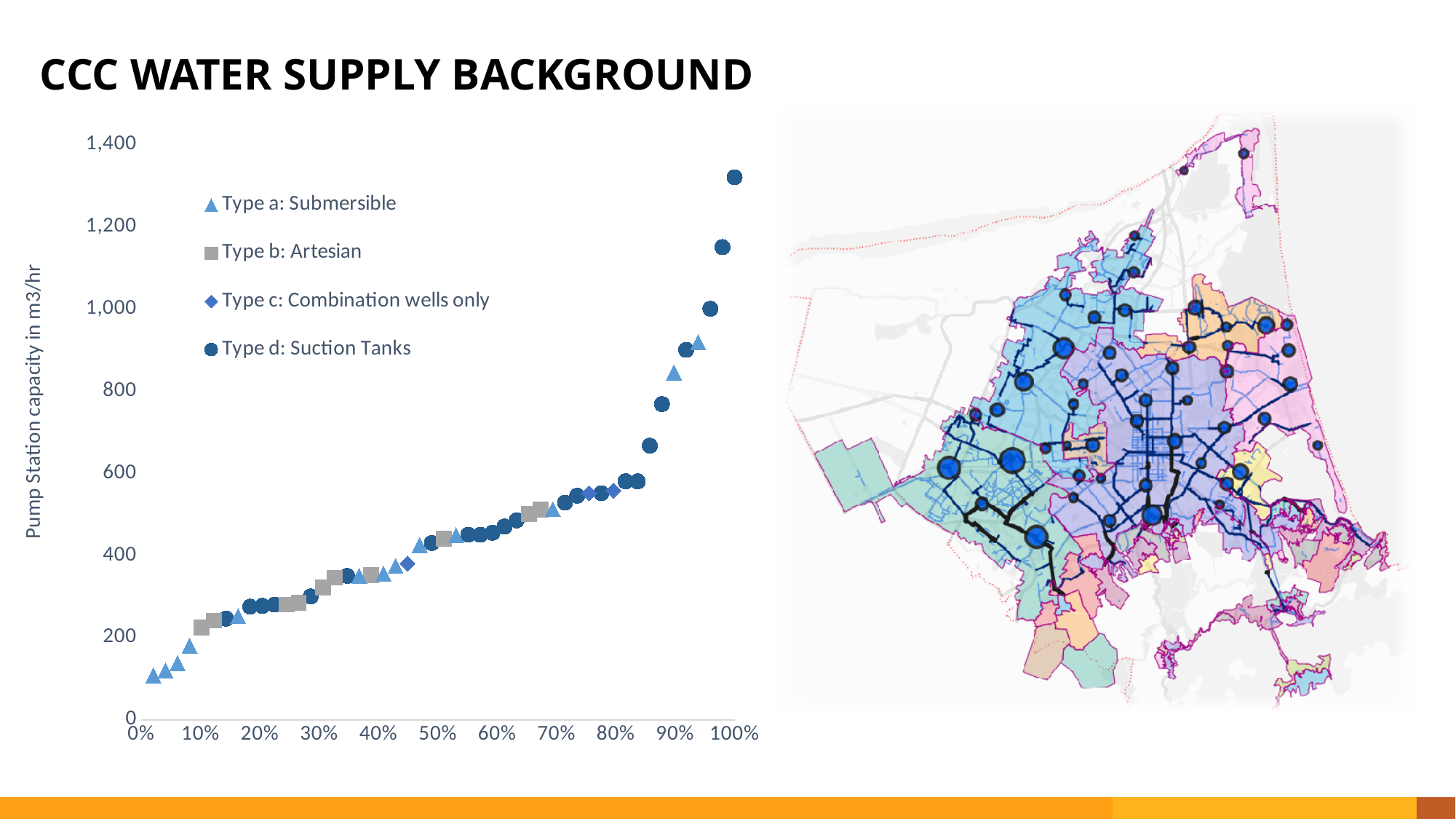
Is the lowest plotted point in the scatter chart greater or less than 200 m3/hr? less In the scatter chart, is the highest Type d: Suction Tanks point larger than the highest Type a: Submersible point? yes Do the plotted values in the scatter chart rise or fall as you move from 0% to 100% along the x axis? rise Which series contains the highest plotted point in the scatter chart? Type d: Suction Tanks How many series does the legend of the scatter chart list? 4 What kind of chart is shown on the left of the slide? scatter chart Which series contains the lowest plotted point in the scatter chart? Type a: Submersible What is the label of the vertical axis of the scatter chart? Pump Station capacity in m3/hr Is the highest plotted point in the scatter chart greater or less than 1,400 m3/hr? less What is the highest value shown on the vertical axis of the scatter chart? 1,400 Which legend entry is shown with a triangle marker in the scatter chart? Type a: Submersible Is the highest plotted point in the scatter chart greater or less than 1,200 m3/hr? greater